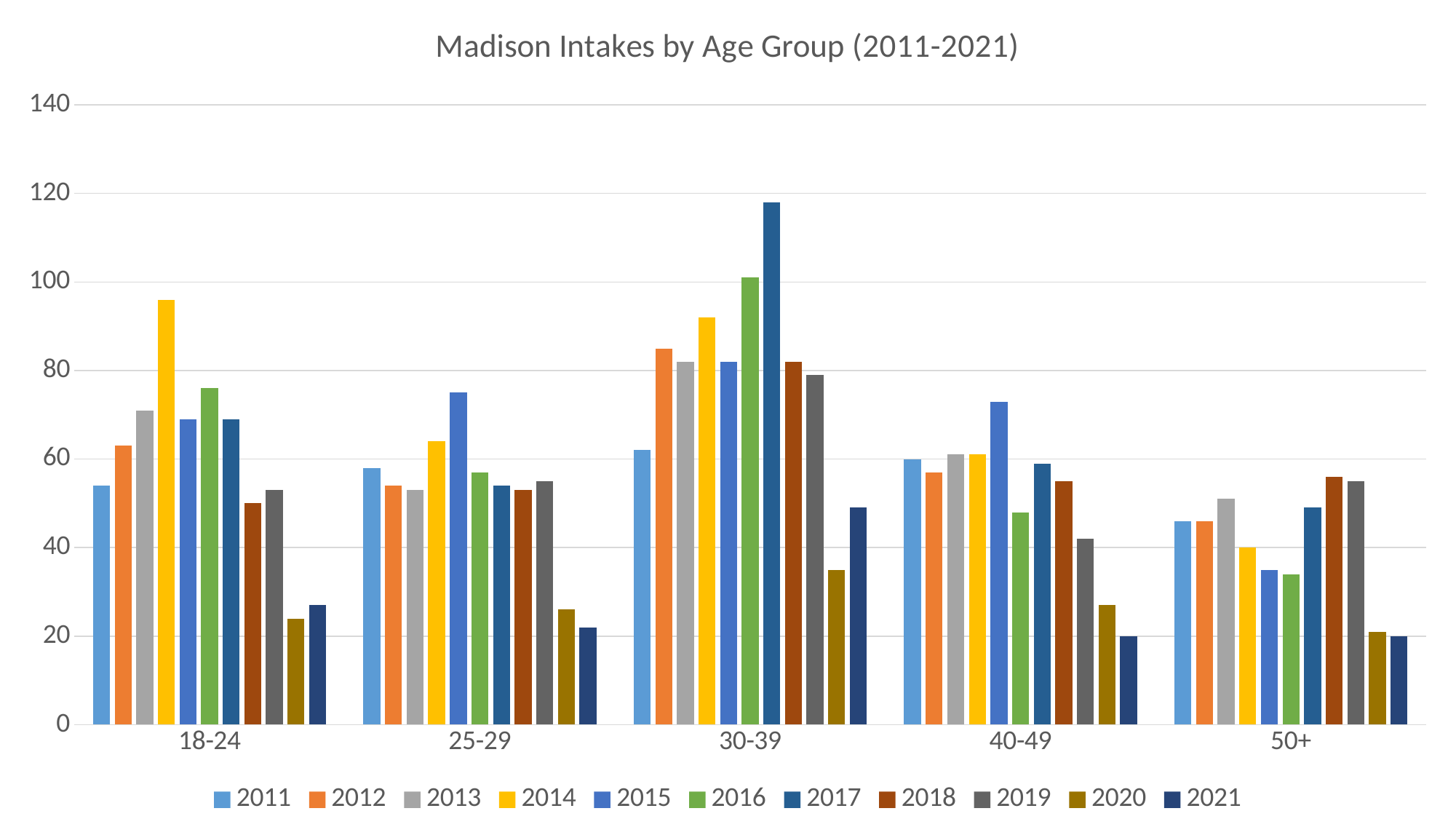
Which year has the lowest value in the 25-29 age group? 2021 How many series does the legend list? 11 Is the value for 2020 in the 18-24 age group greater or less than 40? less Which age group has the tallest bar in the chart? 30-39 Is the value for 2017 in the 30-39 age group greater or less than 100? greater In the 50+ age group, which is larger, the value for 2018 or the value for 2020? 2018 In the 40-49 age group, which is larger, the value for 2015 or the value for 2016? 2015 What kind of chart is shown on the slide? bar chart How many age groups are shown on the x axis? 5 Which year has the highest value in the 18-24 age group? 2014 What is the title of the chart? Madison Intakes by Age Group (2011-2021) Which year has the highest value in the 30-39 age group? 2017